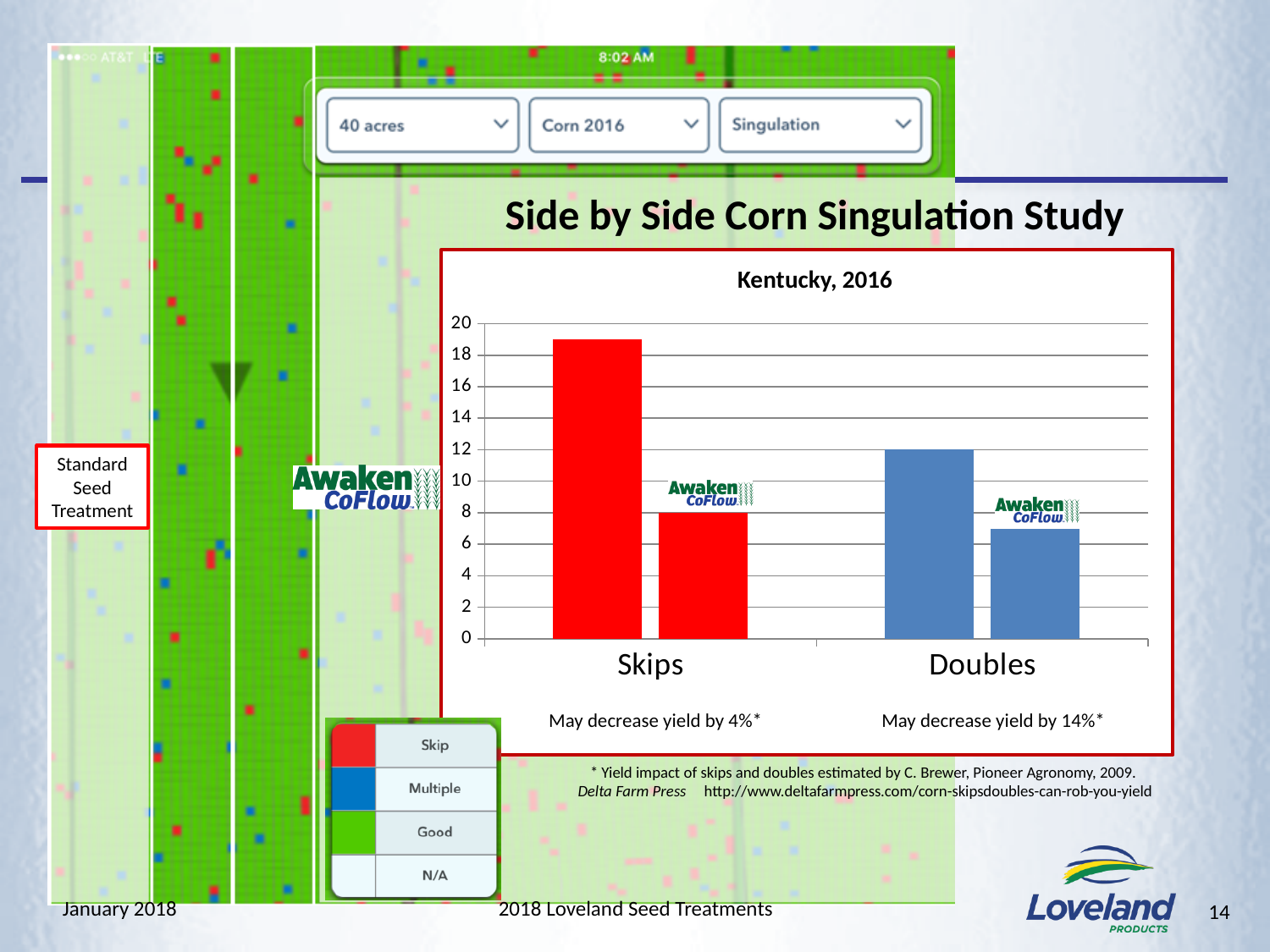
What type of chart is shown on the slide? bar chart What colour are the bars for the Doubles category? blue Is the value of the Standard Seed Treatment bar for Skips greater or less than 18? greater What is the maximum value shown on the y axis of the chart? 20 How many categories are shown on the x axis of the chart? 2 Is the value of the Awaken CoFlow bar for Skips greater or less than 10? less Which bar in the chart is the tallest? Standard Seed Treatment for Skips For Skips, which bar is taller: Standard Seed Treatment or Awaken CoFlow? Standard Seed Treatment Is the value of the Awaken CoFlow bar for Doubles greater or less than 8? less For Doubles, which bar is taller: Standard Seed Treatment or Awaken CoFlow? Standard Seed Treatment What is the title of the chart? Kentucky, 2016